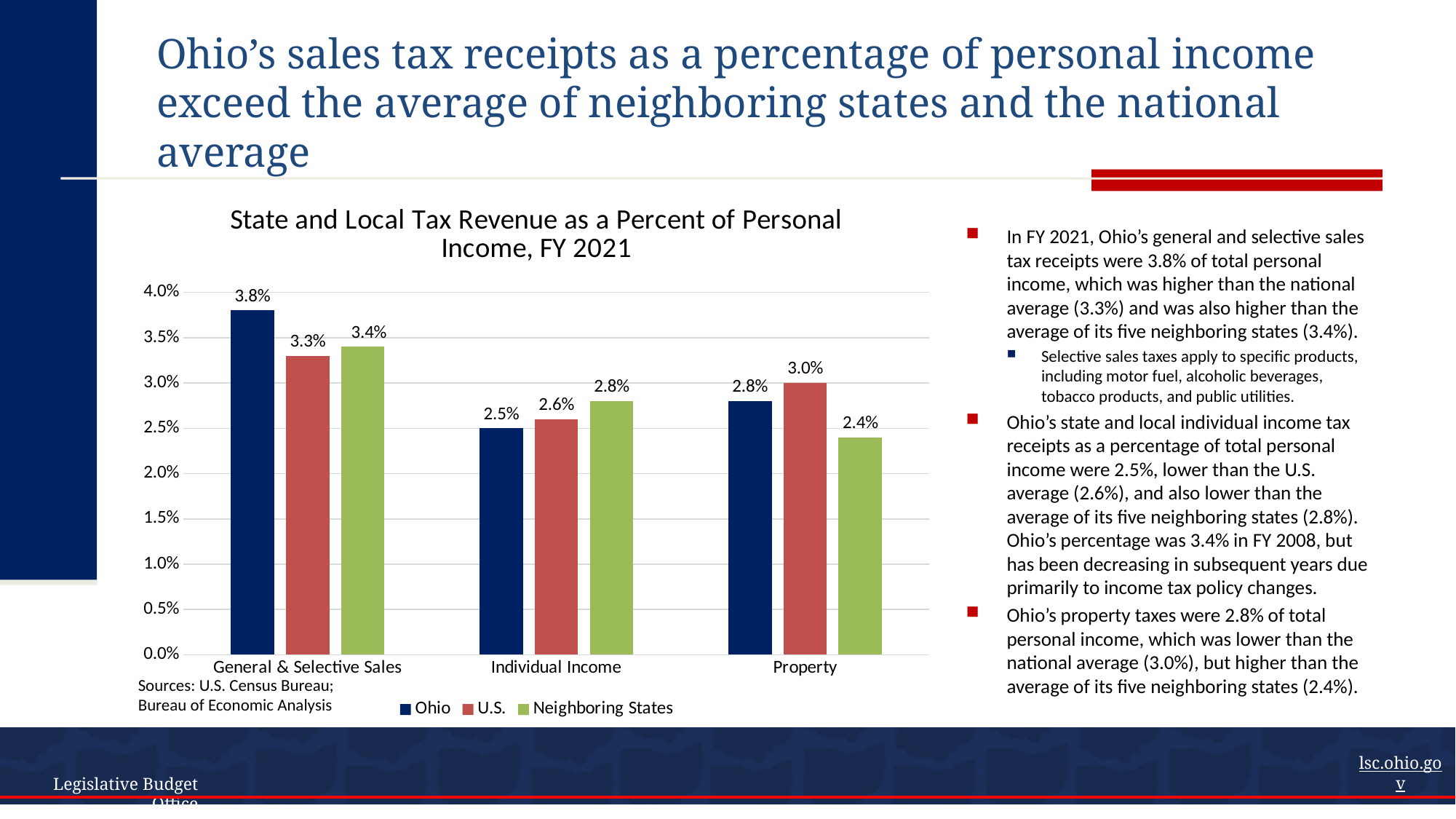
What is the difference between Ohio's and the U.S. value for General & Selective Sales? 0.5% Is the U.S. value for Individual Income greater or less than 3.0%? less How many series does the legend list? 3 What is the Neighboring States value for Individual Income? 2.8% What is the U.S. value for Property? 3.0% Which is larger for Property: the Ohio value or the Neighboring States value? Ohio Which category has the highest Ohio value? General & Selective Sales How many categories are shown on the x axis? 3 What is Ohio's value for General & Selective Sales? 3.8% What is the title of the chart? State and Local Tax Revenue as a Percent of Personal Income, FY 2021 Which category has the lowest Neighboring States value? Property What kind of chart is shown? bar chart